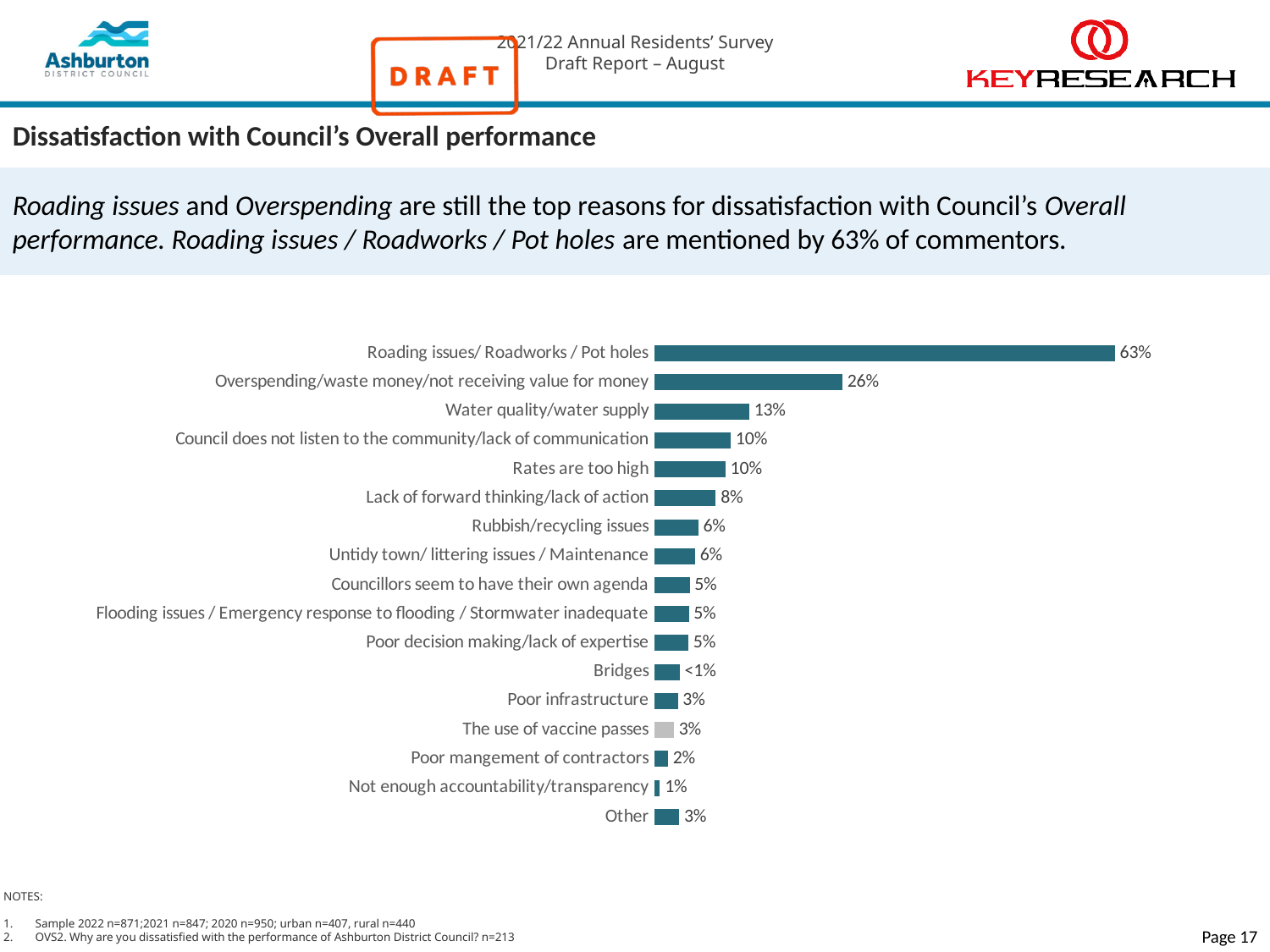
What is the difference between the values for Water quality/water supply and Rates are too high? 3% Which is larger, the value for Rubbish/recycling issues or the value for Poor infrastructure? Rubbish/recycling issues What percentage of commentors mentioned Roading issues/ Roadworks / Pot holes? 63% What is the value for Lack of forward thinking/lack of action? 8% Which reason for dissatisfaction has the highest percentage? Roading issues/ Roadworks / Pot holes Which category's bar is coloured grey rather than teal? The use of vaccine passes What kind of chart is shown on the slide? Bar chart What is the value for Water quality/water supply? 13% How many categories are shown in the chart? 17 What is the difference between the values for Roading issues/ Roadworks / Pot holes and Overspending/waste money/not receiving value for money? 37% What is the value for Overspending/waste money/not receiving value for money? 26% What is the value for Poor mangement of contractors? 2%